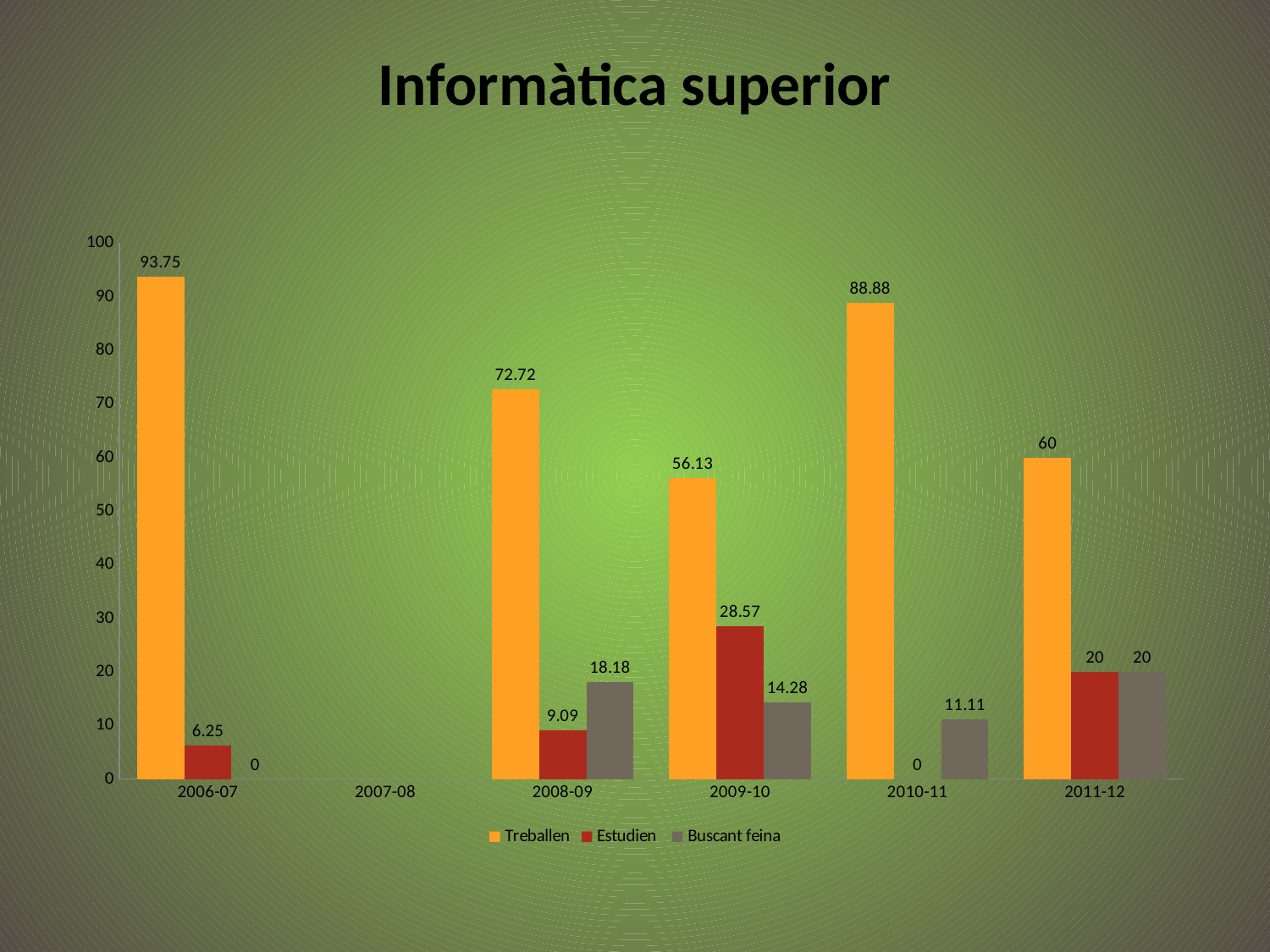
What is the difference between the Treballen values for 2010-11 and 2011-12? 28.88 What is the title of the chart? Informàtica superior What kind of chart is shown on the slide? bar chart What is the value for Buscant feina in 2010-11? 11.11 Is the value for Treballen in 2008-09 greater or less than 70? greater What is the value for Estudien in 2009-10? 28.57 How many series does the legend list? 3 How many year categories are shown on the x axis? 6 Which is larger, Estudien in 2008-09 or Buscant feina in 2008-09? Buscant feina in 2008-09 In which year is the Treballen value highest? 2006-07 Among the years with bars shown, in which year is the Treballen value lowest? 2009-10 What is the value for Treballen in 2006-07? 93.75